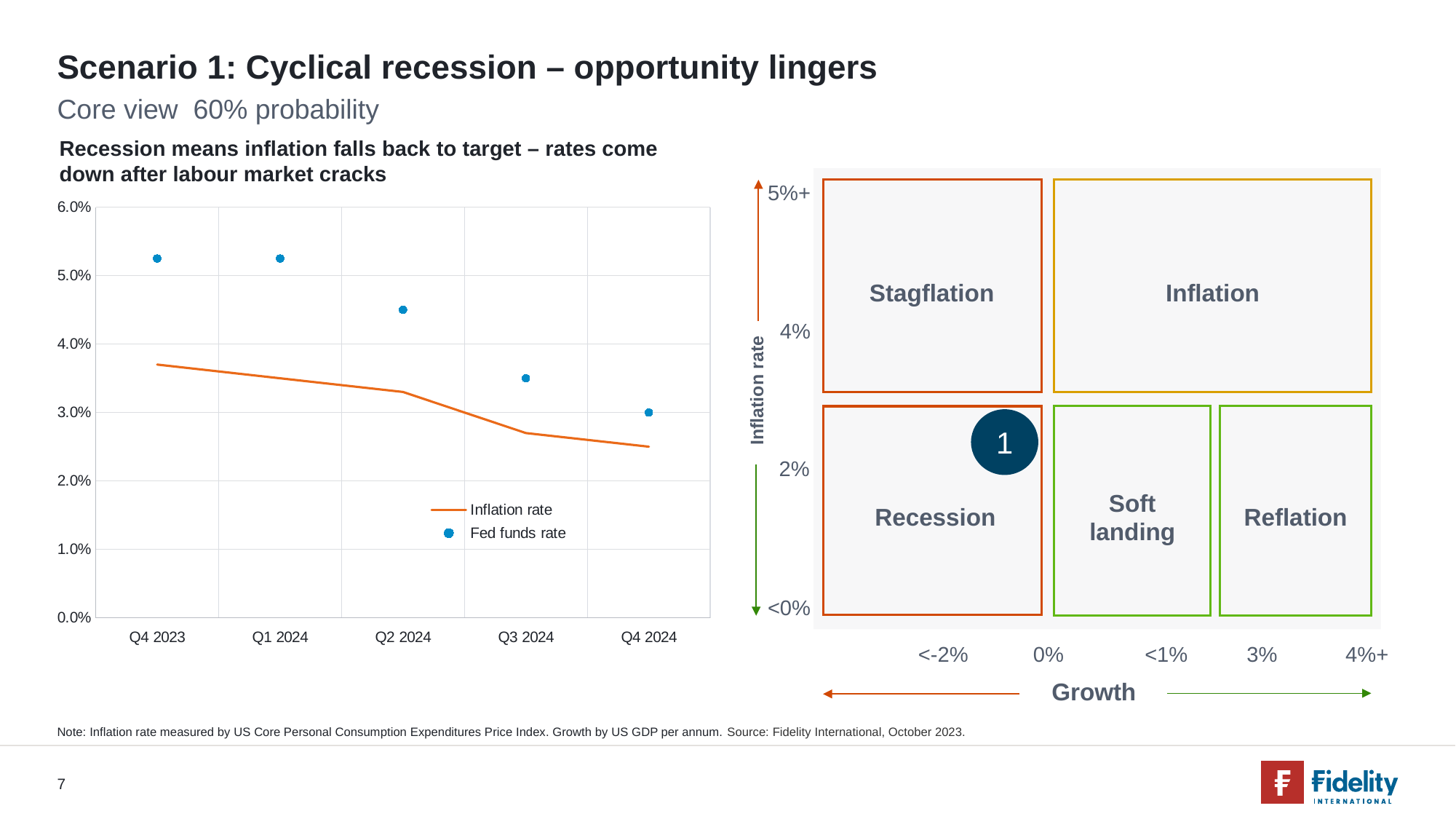
What kind of chart is shown on the left of the slide? line chart How many series does the legend of the left chart list? 2 In the left chart, is the inflation rate for Q4 2023 greater or less than 4.0%? less In the left chart, which quarter has the highest inflation rate? Q4 2023 In the left chart, is the Fed funds rate for Q4 2023 greater or less than 5.0%? greater In the left chart, is the Fed funds rate for Q2 2024 greater or less than 4.0%? greater How many quarters are shown on the x axis of the left chart? 5 In the left chart, does the inflation rate rise or fall from Q4 2023 to Q4 2024? fall In the left chart, does the Fed funds rate rise or fall from Q4 2023 to Q4 2024? fall In the left chart, which quarter has the lowest Fed funds rate? Q4 2024 In the left chart, which is larger for Q4 2023: the Fed funds rate or the inflation rate? Fed funds rate